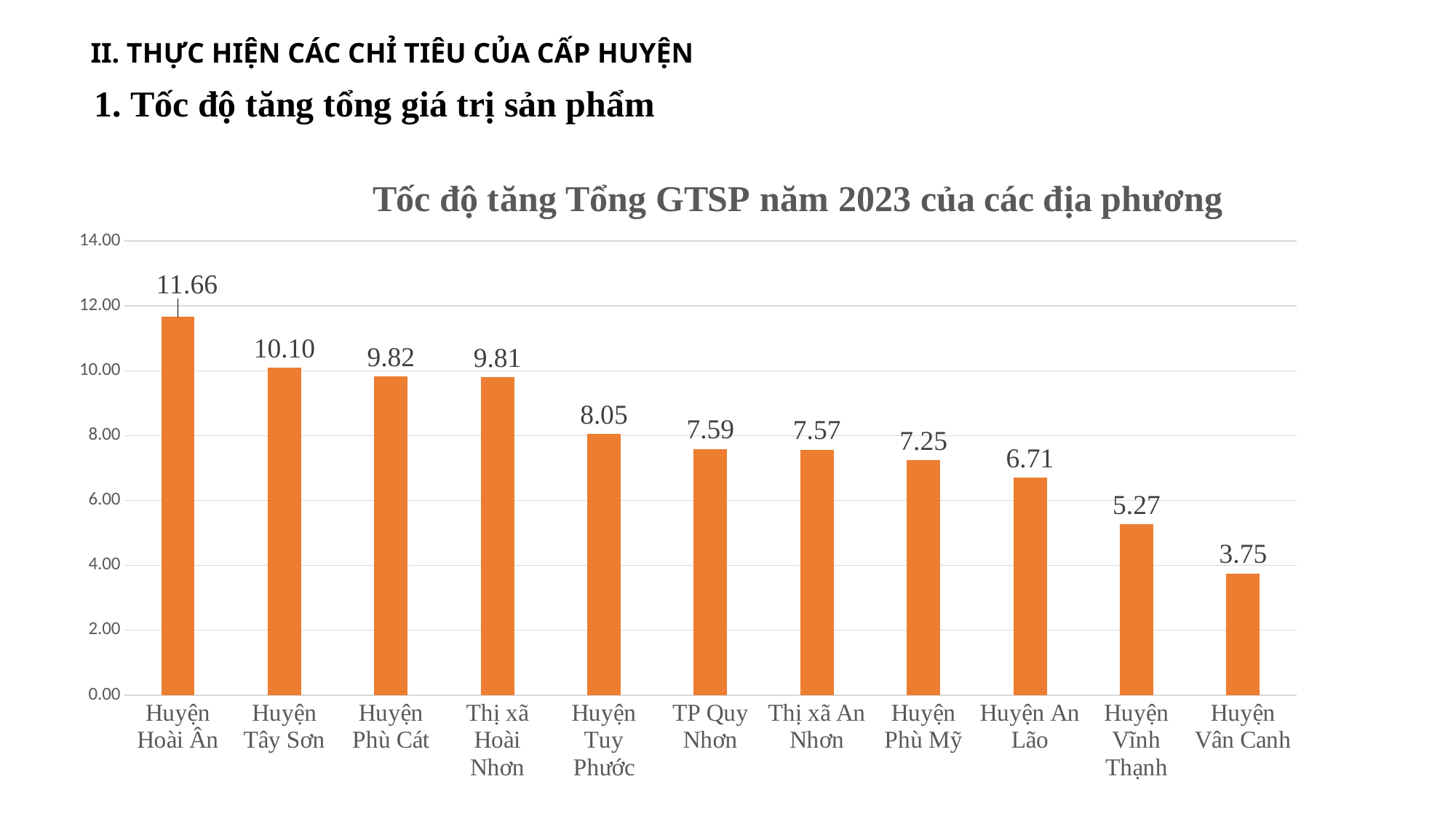
What is the difference between the values for Huyện Tây Sơn and Huyện Phù Mỹ? 2.85 Which is larger, the value for Huyện Tuy Phước or the value for Huyện An Lão? Huyện Tuy Phước What kind of chart is this? bar chart Which locality has the highest value? Huyện Hoài Ân Is the value for Huyện Phù Cát greater or less than 10.00? less Do the values rise or fall from left to right along the x axis? fall What is the value for TP Quy Nhơn? 7.59 What is the title of the chart? Tốc độ tăng Tổng GTSP năm 2023 của các địa phương What is the value for Huyện Hoài Ân? 11.66 Which locality has the lowest value? Huyện Vân Canh How many localities are shown on the chart? 11 What is the value for Huyện Vĩnh Thạnh? 5.27